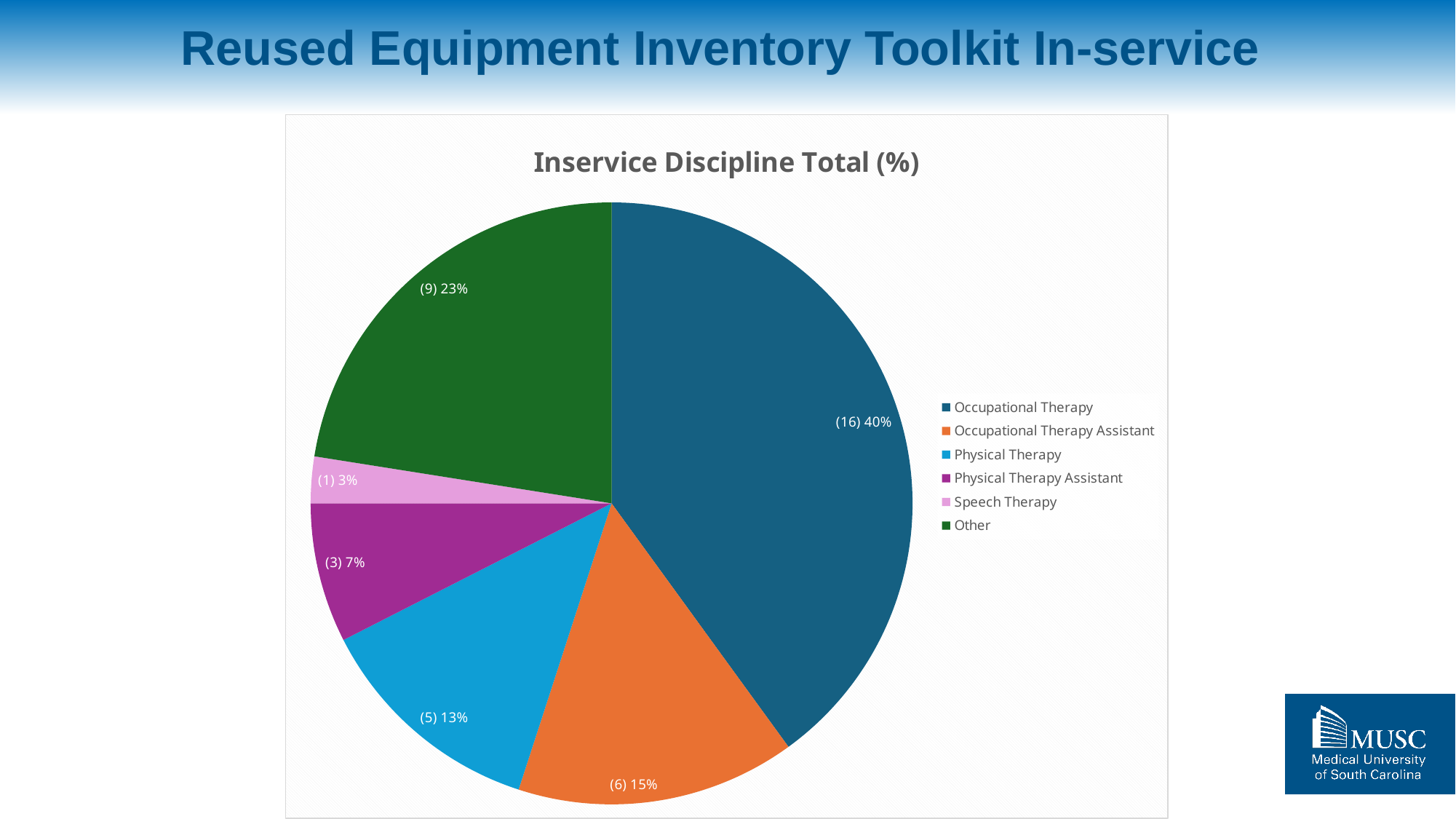
What kind of chart is shown on the slide? Pie chart Which discipline has the largest slice? Occupational Therapy Which is larger, the Physical Therapy slice or the Physical Therapy Assistant slice? Physical Therapy Which discipline has the smallest slice? Speech Therapy What is the title of the chart? Inservice Discipline Total (%) What is the count shown for Physical Therapy? 5 What is the count shown for Speech Therapy? 1 What is the difference in percentage points between Occupational Therapy and Occupational Therapy Assistant? 25 What percentage share does Other have? 23% How many slices does the pie chart have? 6 What colour is the Other slice? Green What percentage share does Occupational Therapy have? 40%